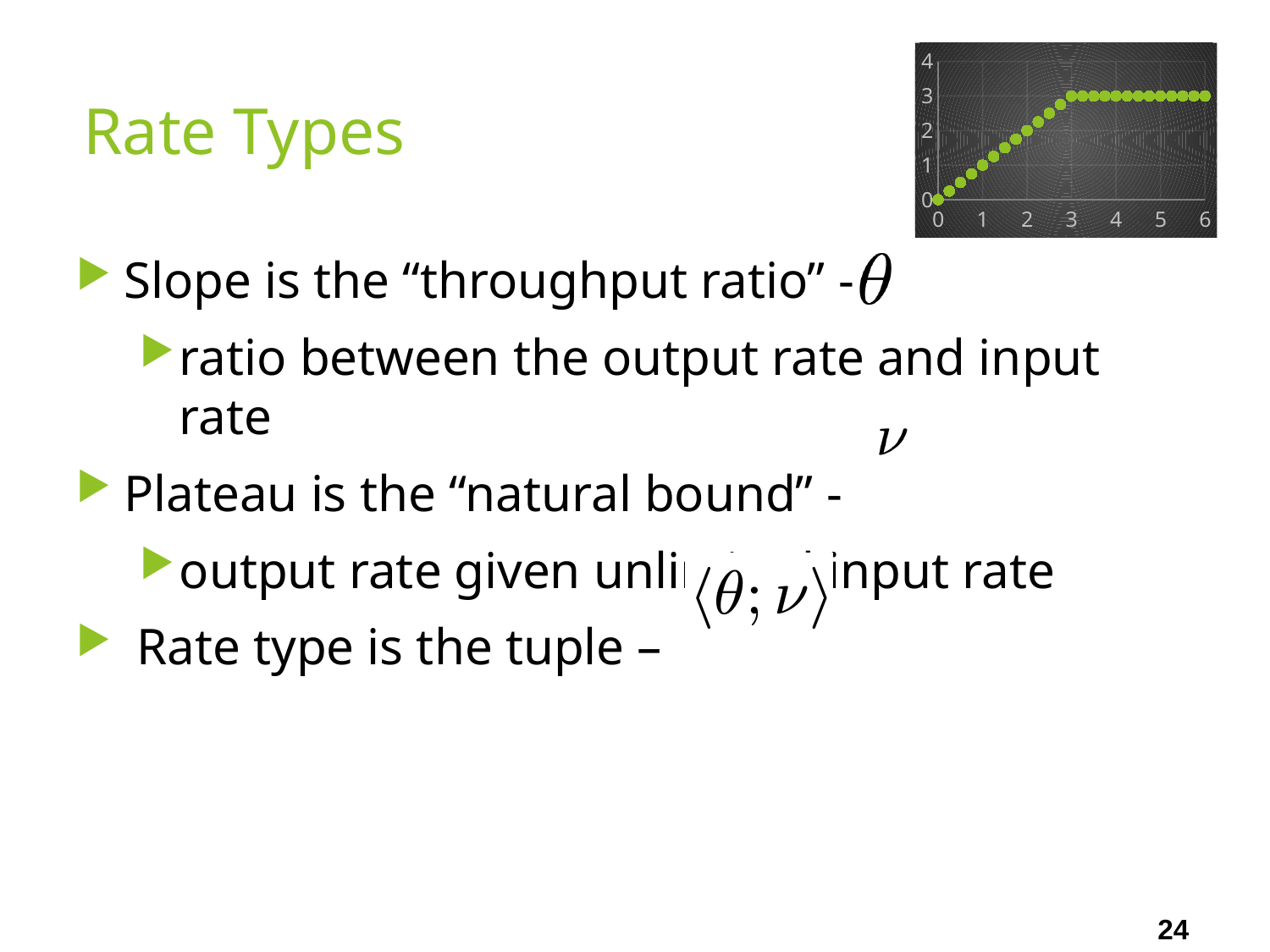
Is the value plotted at x = 4 greater or less than 4? less What is the highest tick label shown on the chart's y axis? 4 Which is larger: the value plotted at x = 1 or the value plotted at x = 5? x = 5 At what y value does the plateau of the plotted points sit? 3 What kind of chart is shown in the top-right corner of the slide? scatter chart In the chart, do the values rise, fall, or stay flat as x goes from 3 to 6? stay flat Is the value plotted at x = 5 greater or less than 2? greater Is the value plotted at x = 1 greater or less than 2? less In the chart, do the values rise, fall, or stay flat as x goes from 0 to 3? rise What is the y value of the plotted point at x = 0? 0 What is the highest tick label shown on the chart's x axis? 6